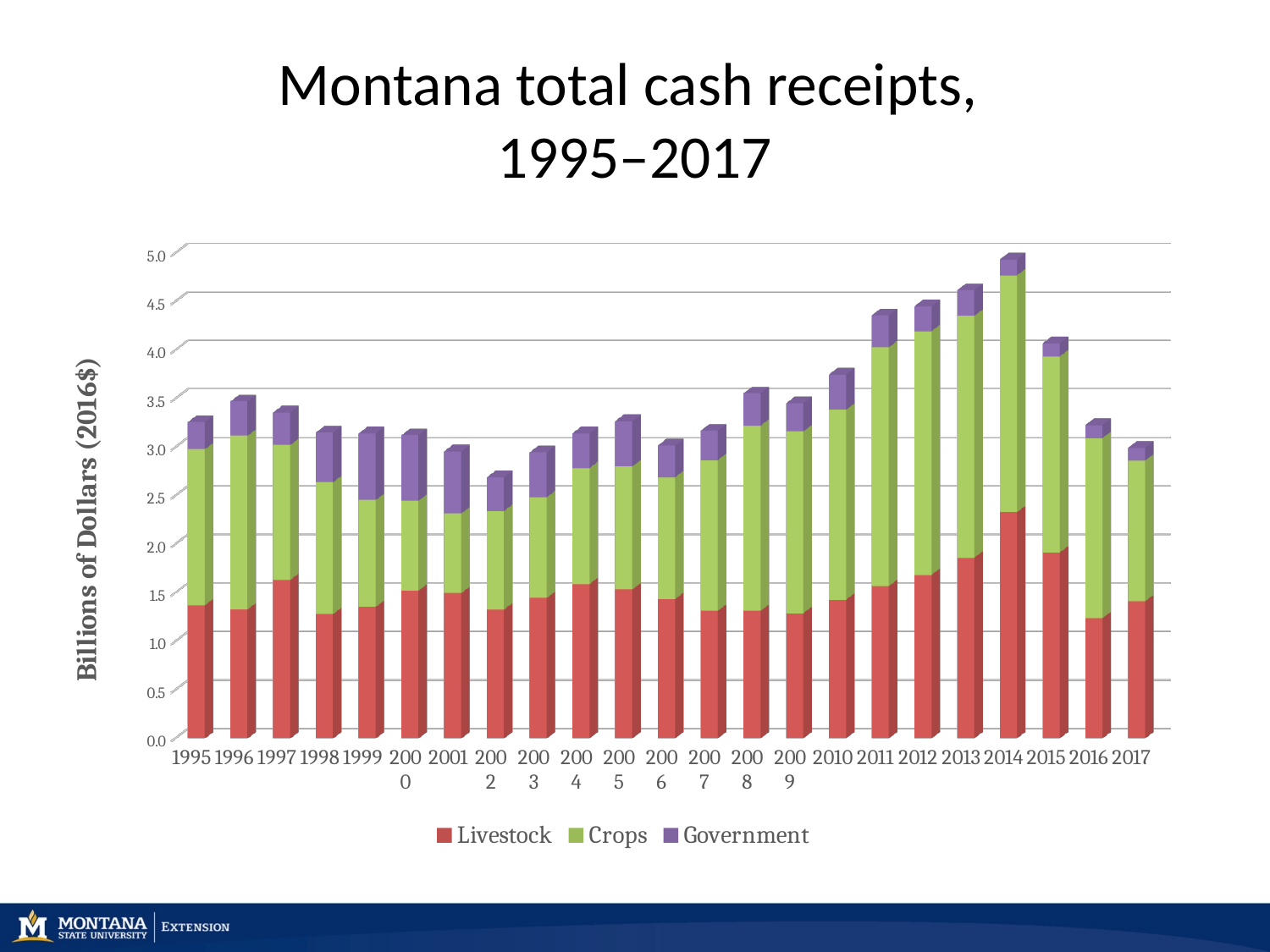
Which year has the highest total cash receipts? 2014 How many series does the legend list? 3 Do total cash receipts rise or fall from 2009 to 2014? Rise Which year has the lowest total cash receipts? 2002 Is the total cash receipts value for 2014 greater or less than 4.5? greater What is the label on the vertical axis? Billions of Dollars (2016$) How many years are plotted along the x axis? 23 Which year has larger total cash receipts, 2008 or 2003? 2008 Is the total cash receipts value for 2017 greater or less than 3.5? less What kind of chart is shown on the slide? Bar chart Is the Livestock value for 2014 greater or less than 2.0? greater